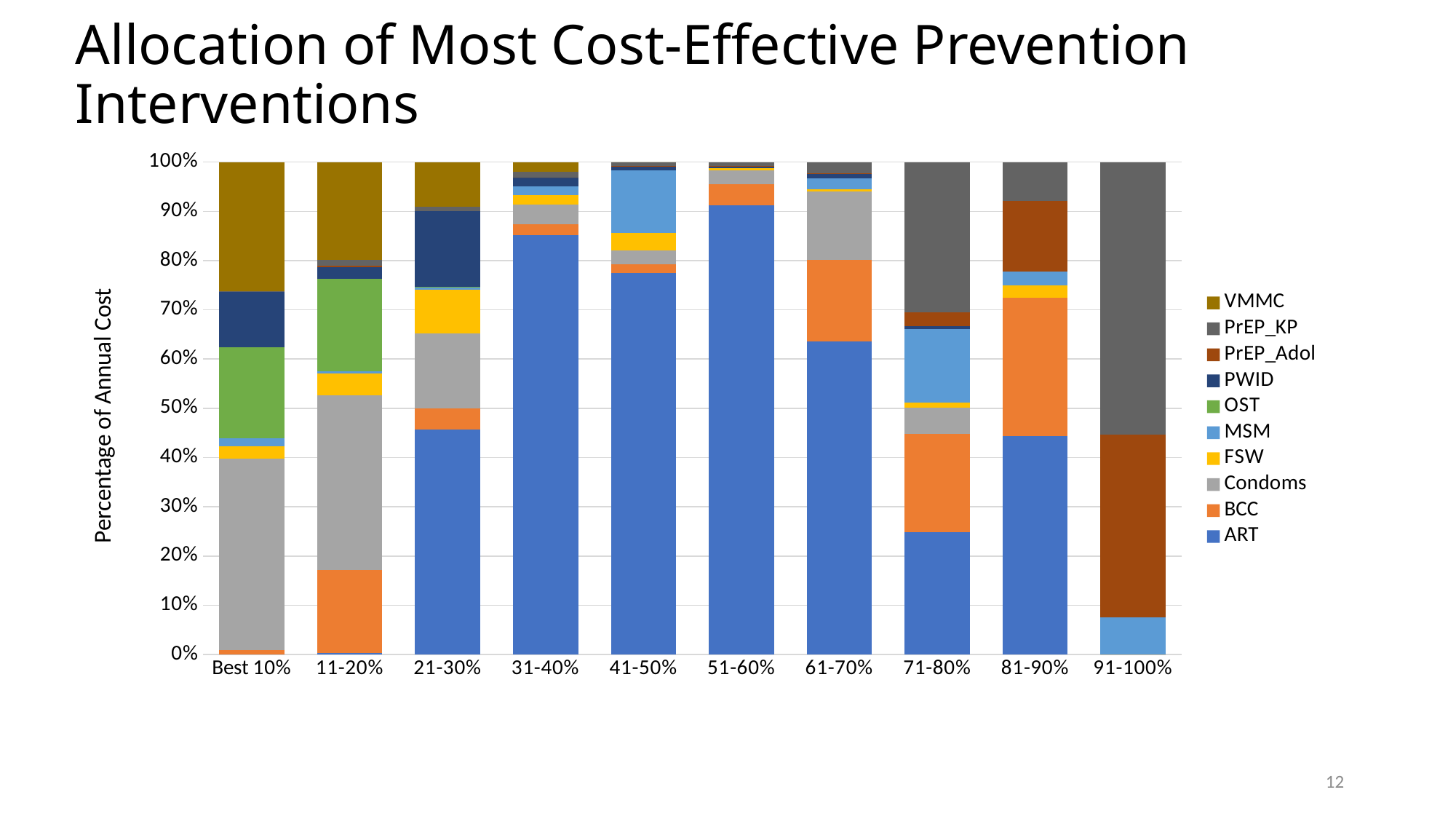
Which category has the largest VMMC segment? Best 10% What is the total of the stacked bar for 31-40%? 100% Is the ART segment for 31-40% greater or less than 80%? greater Is the Condoms segment for Best 10% greater or less than 30%? greater Is the ART segment for 21-30% greater or less than 50%? less What is the label of the y axis? Percentage of Annual Cost Which is larger, the ART segment for 51-60% or the ART segment for 71-80%? 51-60% How many categories are shown along the x axis? 10 How many series does the legend list? 10 What kind of chart is shown on the slide? Stacked bar chart Which category has the largest ART segment? 51-60%